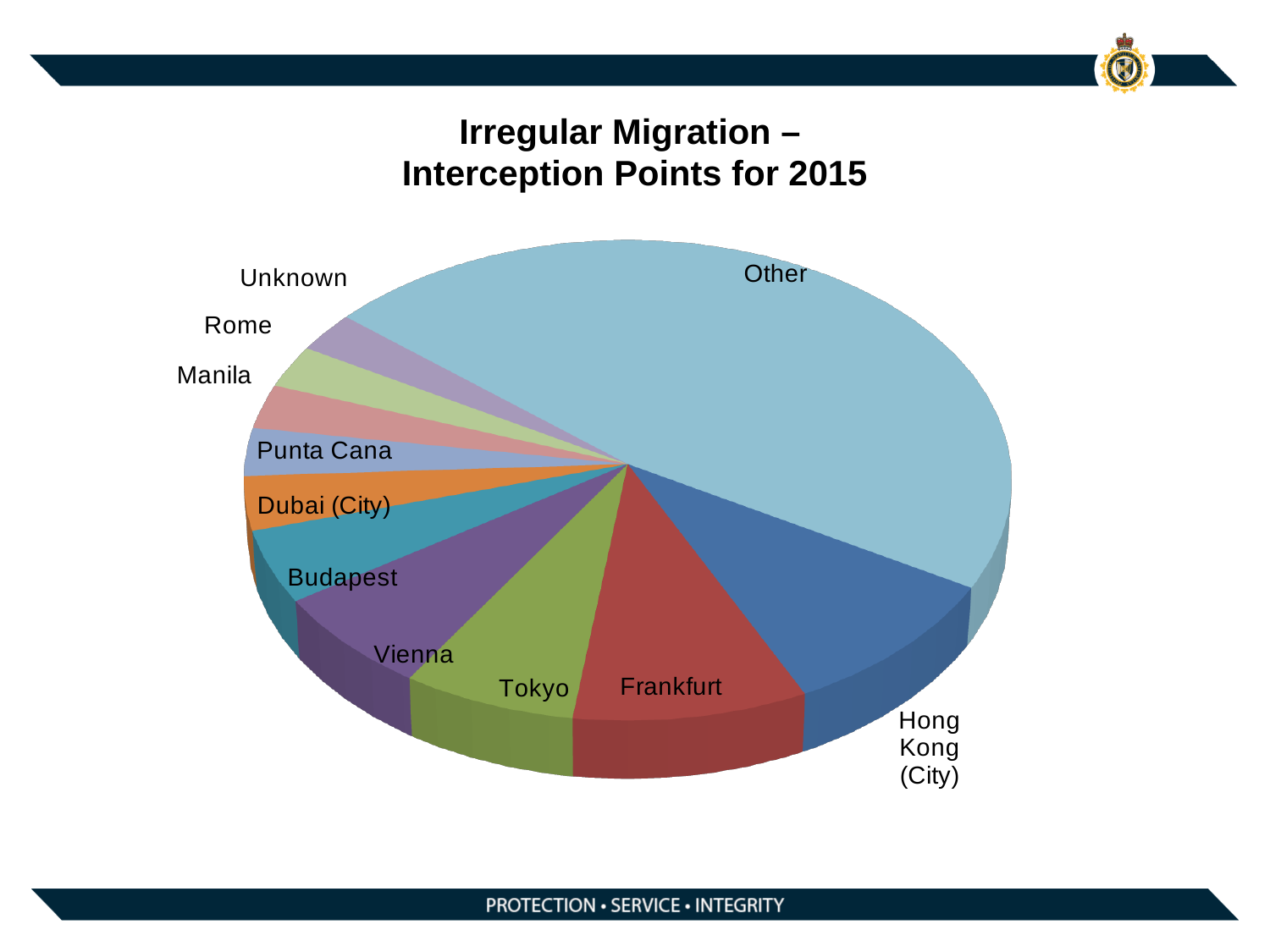
How many slices does the pie chart have? 11 What kind of chart is shown on the slide? pie chart Which slice is larger, Frankfurt or Budapest? Frankfurt What is the title of the chart? Irregular Migration – Interception Points for 2015 Which slice is larger, Tokyo or Punta Cana? Tokyo Which slice is larger, Hong Kong (City) or Tokyo? Hong Kong (City) Which category has the largest slice of the pie? Other